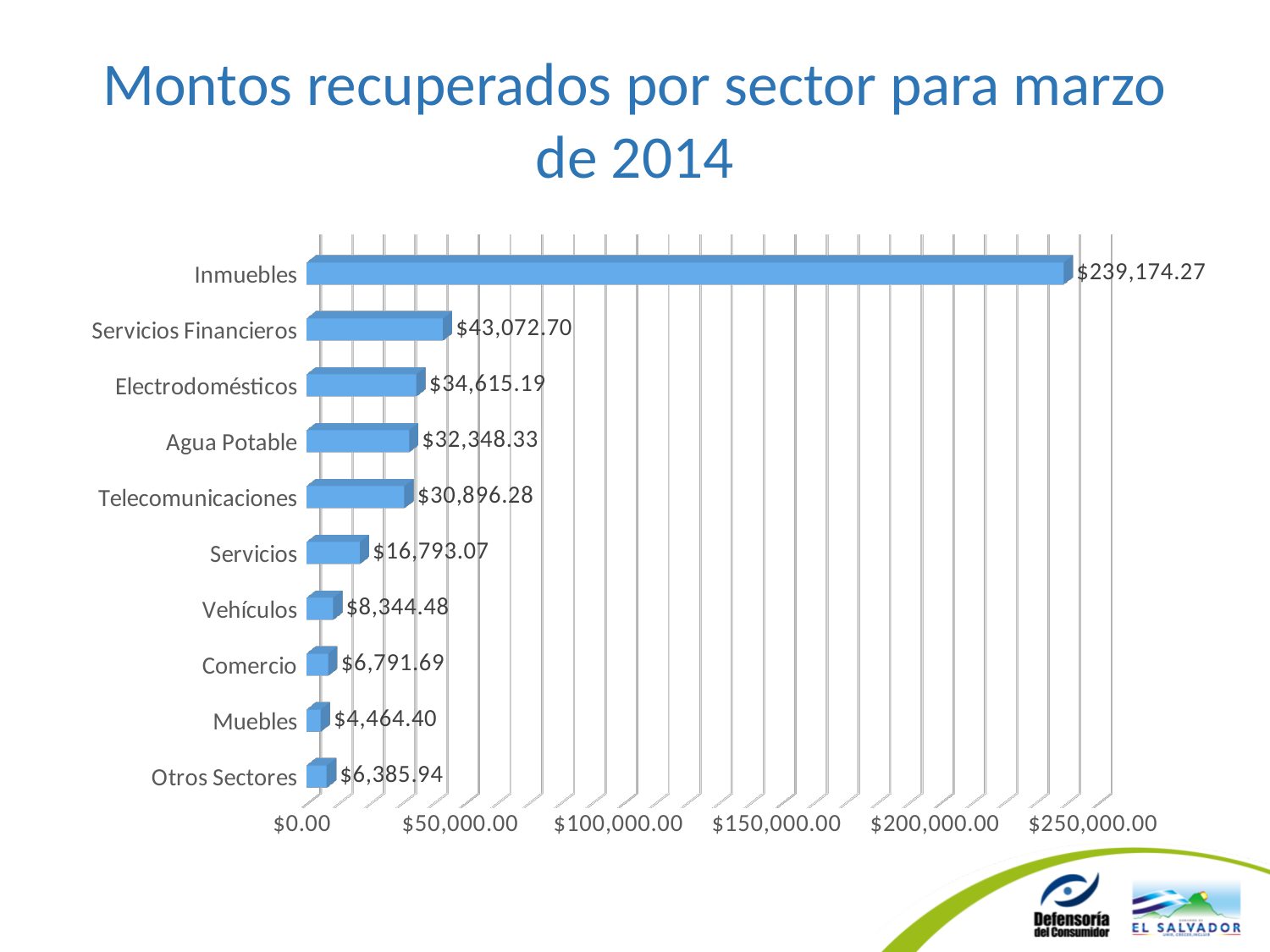
What kind of chart is shown on the slide? bar chart What is the value for Muebles? $4,464.40 Which sector has the lowest recovered amount? Muebles What is the title of the chart? Montos recuperados por sector para marzo de 2014 Which sector has the highest recovered amount? Inmuebles What is the difference between the values for Inmuebles and Servicios Financieros? $196,101.57 Which is larger, the value for Agua Potable or the value for Telecomunicaciones? Agua Potable Is the value for Inmuebles greater or less than $200,000.00? greater What is the difference between the values for Servicios Financieros and Electrodomésticos? $8,457.51 What is the value for Telecomunicaciones? $30,896.28 How many sectors are shown in the chart? 10 What is the value for Inmuebles? $239,174.27